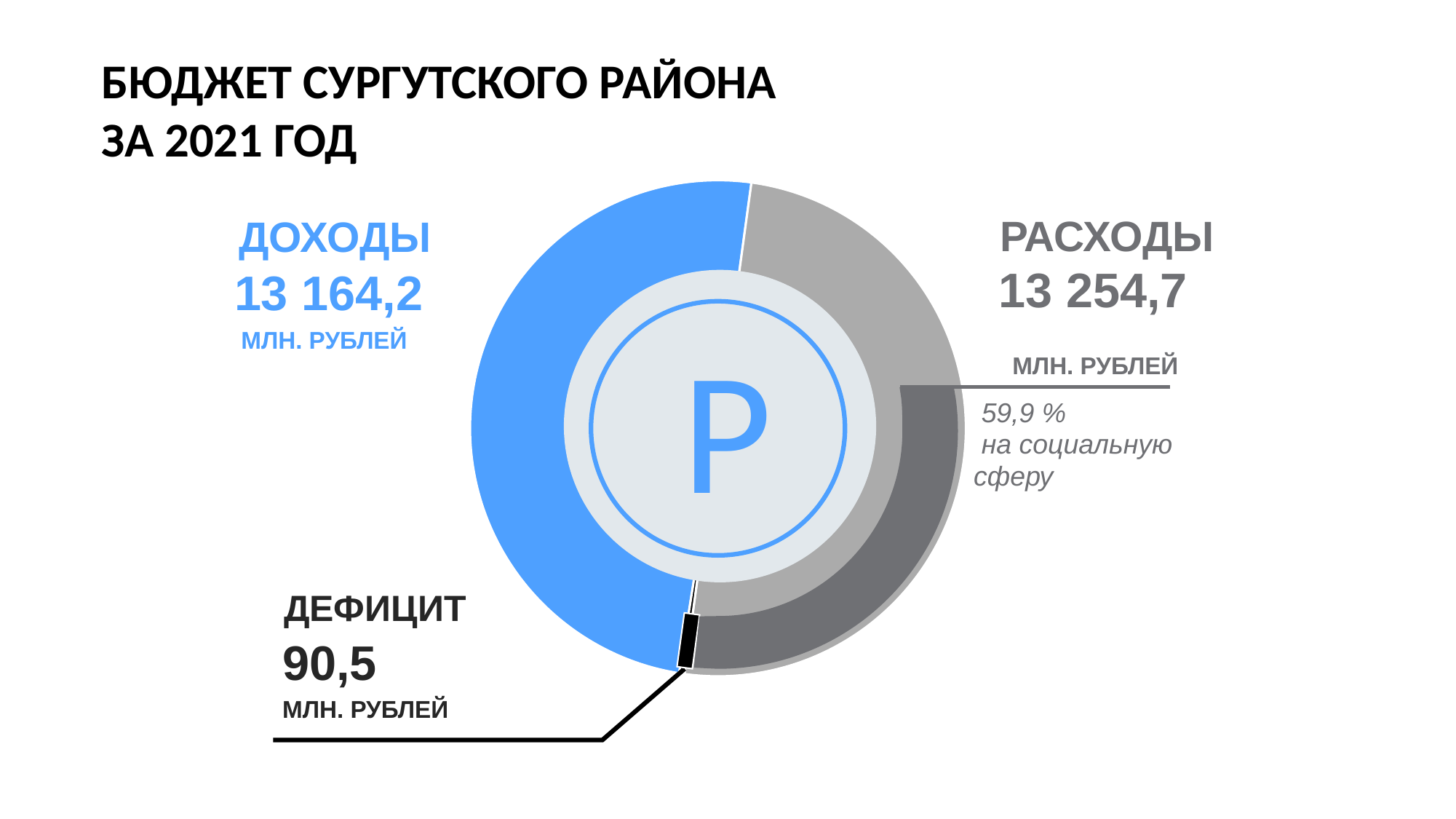
What is the value shown for ДЕФИЦИТ? 90,5 млн. рублей What is the difference between РАСХОДЫ and ДОХОДЫ in млн. рублей? 90,5 What kind of chart is shown on the slide? Pie (donut) chart What is the value shown for РАСХОДЫ? 13 254,7 млн. рублей Which of the labelled values on the chart is the largest? РАСХОДЫ What colour is the ДОХОДЫ segment of the chart? Blue What percentage of expenses (РАСХОДЫ) went to the social sphere (на социальную сферу)? 59,9 % Which of the labelled values on the chart is the smallest? ДЕФИЦИТ Which is larger, ДОХОДЫ or РАСХОДЫ? РАСХОДЫ What is the title of the slide? БЮДЖЕТ СУРГУТСКОГО РАЙОНА ЗА 2021 ГОД What is the value shown for ДОХОДЫ? 13 164,2 млн. рублей How many labelled categories are shown on the chart? 3